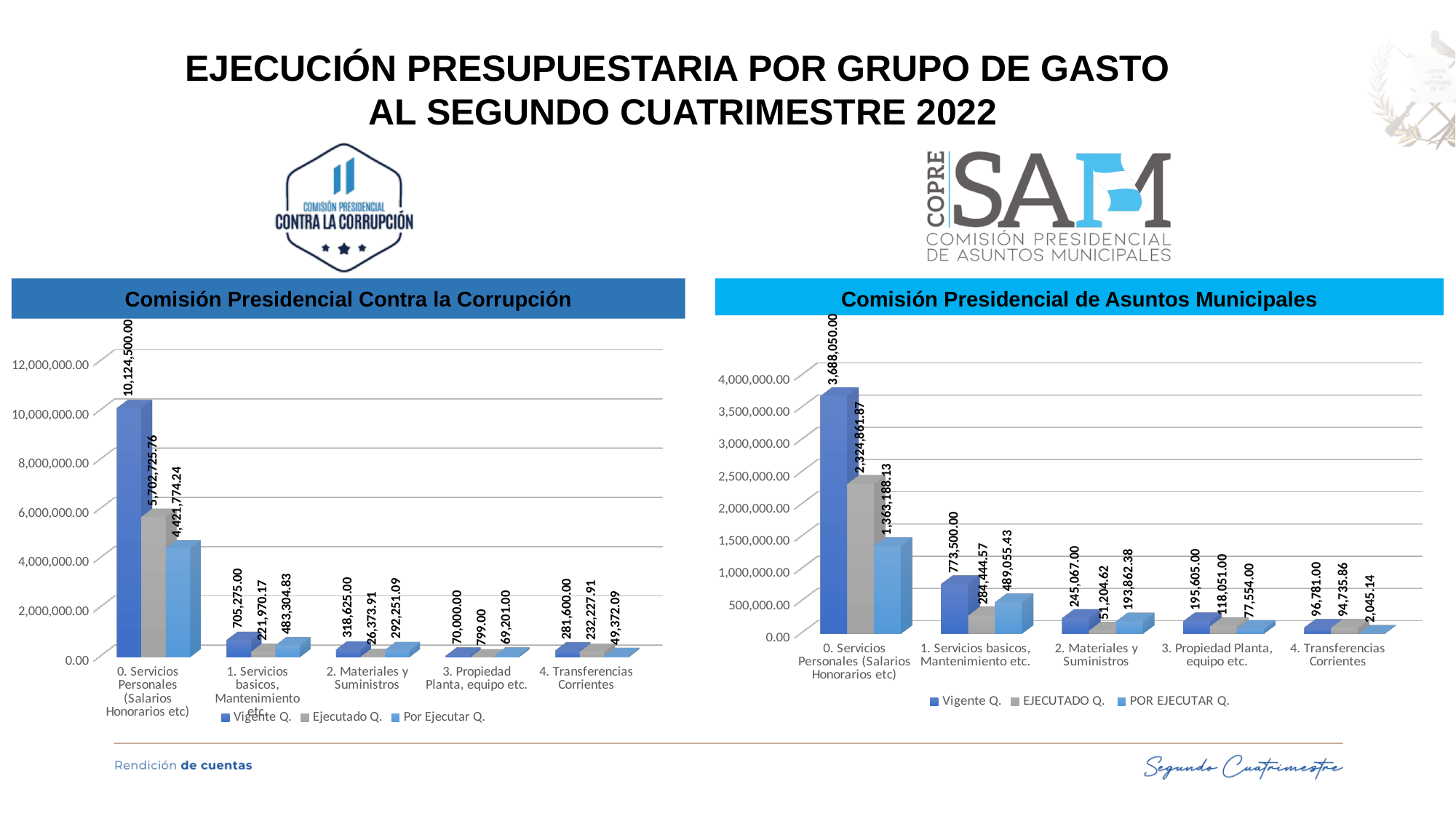
In the Comisión Presidencial de Asuntos Municipales chart, how many categories are shown on the x axis? 5 In the Comisión Presidencial Contra la Corrupción chart, what is the difference between the Vigente Q. and Ejecutado Q. values for 4. Transferencias Corrientes? 49,372.09 In the Comisión Presidencial Contra la Corrupción chart, what is the Vigente Q. value for 0. Servicios Personales (Salarios Honorarios etc)? 10,124,500.00 In the Comisión Presidencial de Asuntos Municipales chart, which is larger for 1. Servicios basicos, Mantenimiento etc.: EJECUTADO Q. or POR EJECUTAR Q.? POR EJECUTAR Q. In the Comisión Presidencial de Asuntos Municipales chart, what is the POR EJECUTAR Q. value for 4. Transferencias Corrientes? 2,045.14 In the Comisión Presidencial Contra la Corrupción chart, which category has the lowest Ejecutado Q. value? 3. Propiedad Planta, equipo etc. In the Comisión Presidencial de Asuntos Municipales chart, what is the EJECUTADO Q. value for 0. Servicios Personales (Salarios Honorarios etc)? 2,324,861.87 In the Comisión Presidencial de Asuntos Municipales chart, what is the difference between the Vigente Q. and EJECUTADO Q. values for 3. Propiedad Planta, equipo etc.? 77,554.00 In the Comisión Presidencial Contra la Corrupción chart, which category has the highest Vigente Q. value? 0. Servicios Personales (Salarios Honorarios etc) What kind of chart is the Comisión Presidencial de Asuntos Municipales chart? Bar chart In the Comisión Presidencial Contra la Corrupción chart, how many series does the legend list? 3 In the Comisión Presidencial Contra la Corrupción chart, what is the Ejecutado Q. value for 3. Propiedad Planta, equipo etc.? 799.00